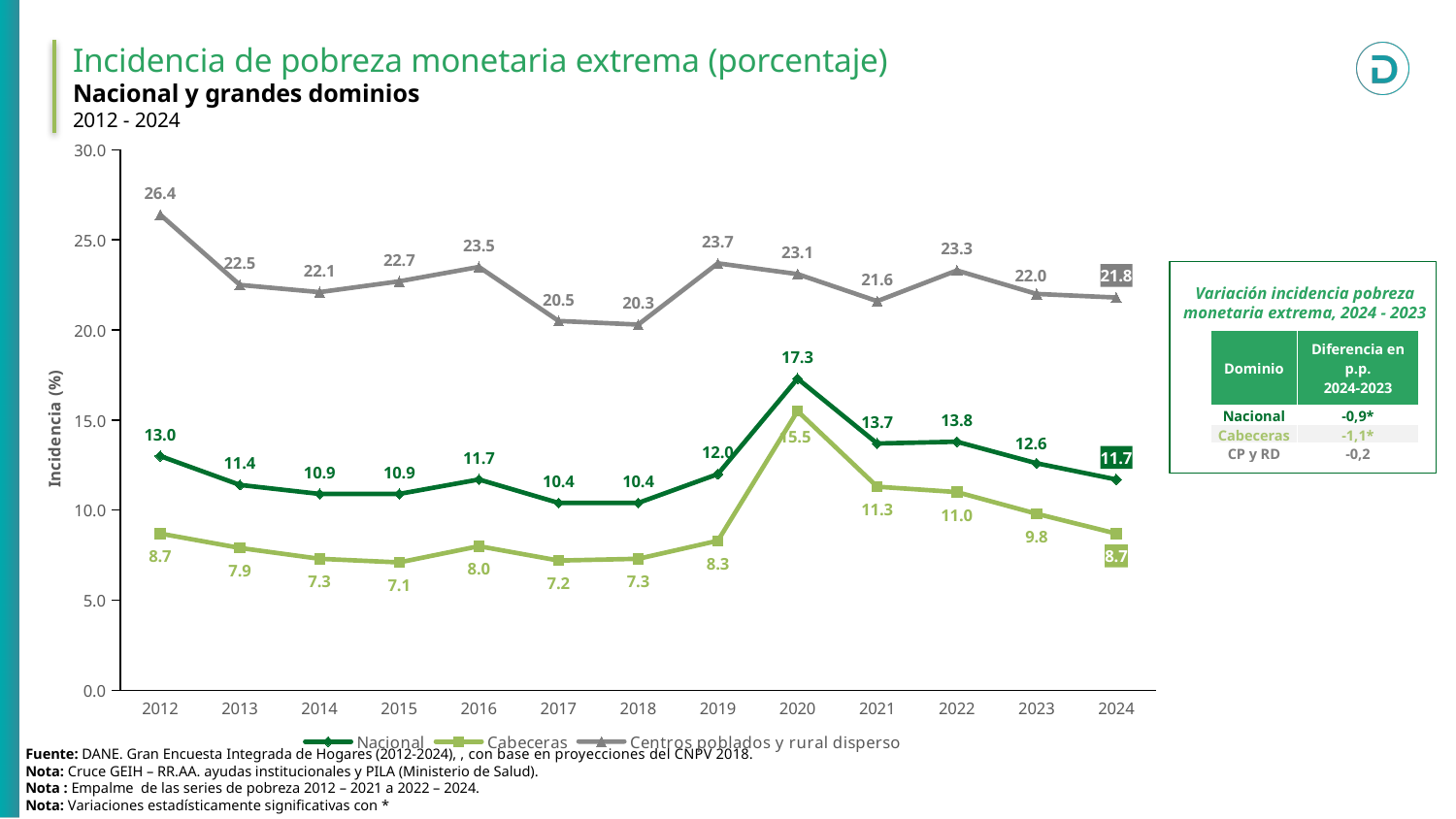
What is the value for Centros poblados y rural disperso in 2012? 26.4 What is the value for Cabeceras in 2015? 7.1 What is the difference between the Nacional value in 2020 and in 2024? 5.6 Does the Nacional series rise or fall from 2022 to 2024? Fall In which year is the Centros poblados y rural disperso series at its lowest? 2018 What is the title of the chart? Incidencia de pobreza monetaria extrema (porcentaje) Which is larger, the Cabeceras value in 2021 or in 2022? 2021 How many series does the legend list? 3 What type of chart is shown on the slide? Line chart In which year is the Cabeceras series at its highest? 2020 What is the value for Nacional in 2020? 17.3 How many years are shown on the x axis? 13